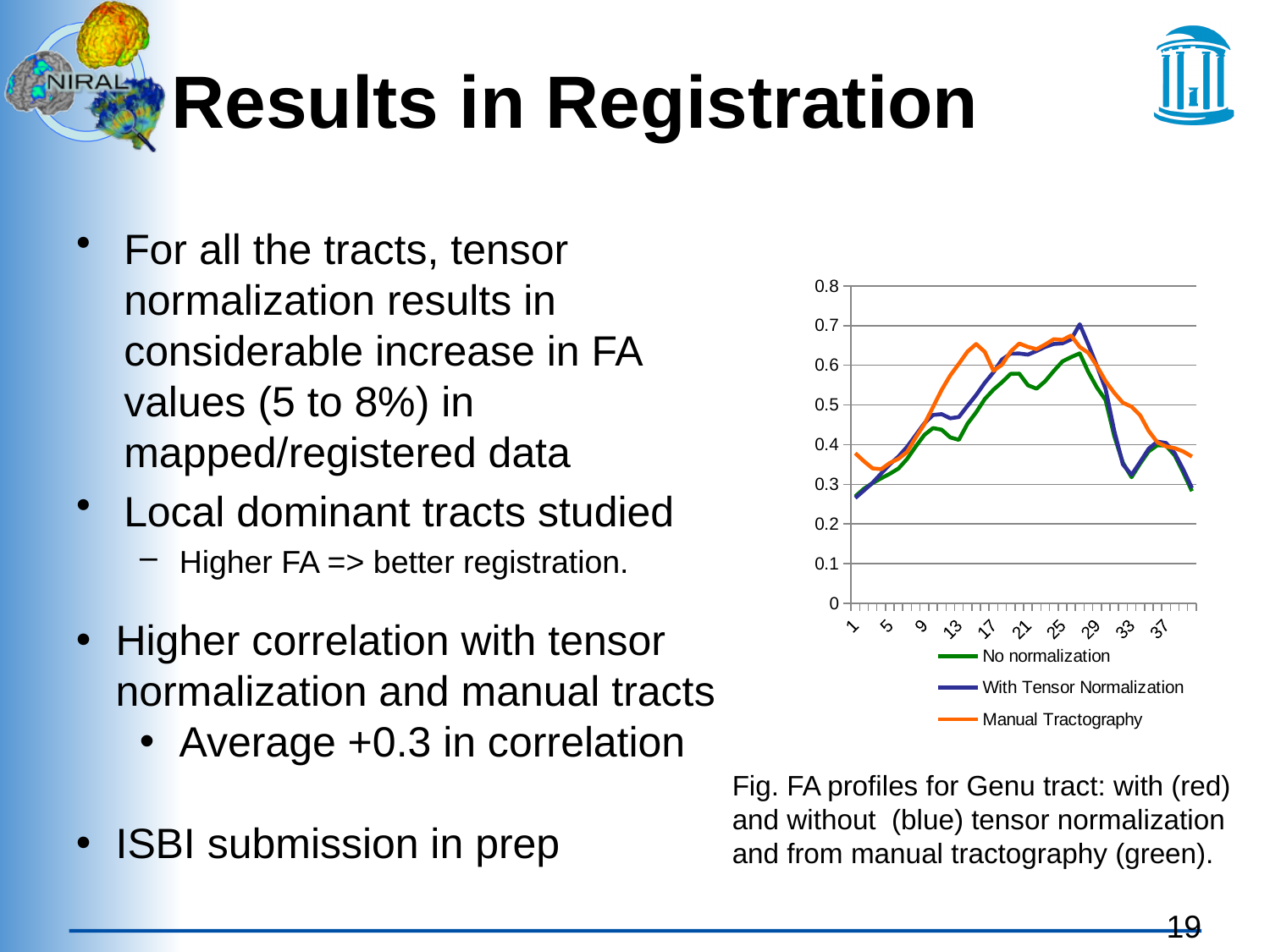
How many series does the chart legend list? 3 Between x = 29 and x = 33, does the No normalization series rise or fall? fall What is the last label shown on the chart's x axis? 37 At x = 13, which series has the higher value, Manual Tractography or No normalization? Manual Tractography What is the highest value shown on the chart's y axis? 0.8 Is the value for Manual Tractography at x = 17 greater or less than 0.5? greater Is the value for No normalization at x = 1 greater or less than 0.4? less At x = 29, which series has the higher value, With Tensor Normalization or No normalization? With Tensor Normalization Is the value for No normalization at x = 33 greater or less than 0.5? less Which series reaches the highest peak value on the chart? With Tensor Normalization What kind of chart is shown on the slide? line chart